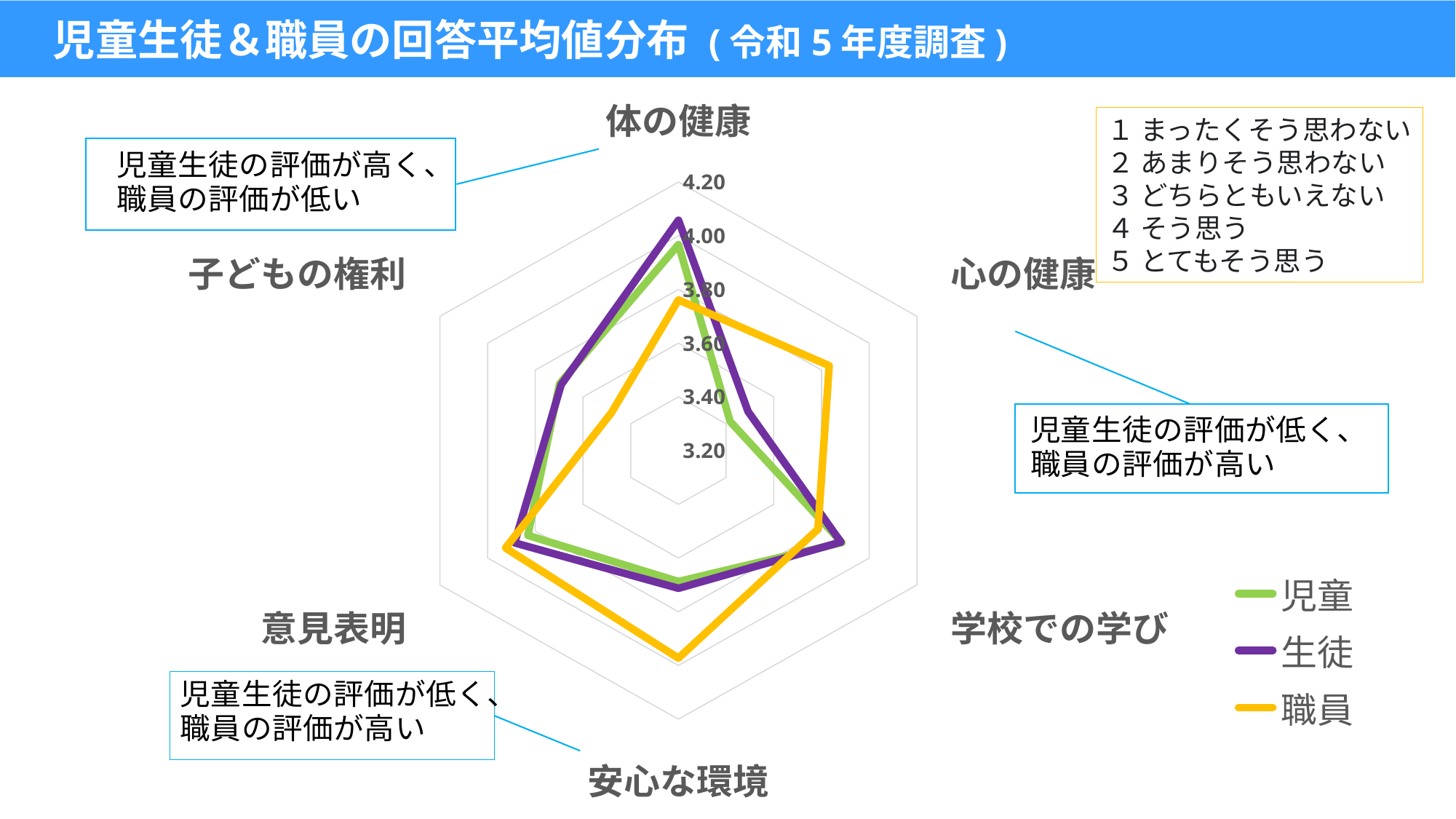
What is the title of the slide? 児童生徒＆職員の回答平均値分布（令和5年度調査） Is the value for 職員 on 子どもの権利 greater or less than 3.60? less Is the value for 生徒 on 体の健康 greater or less than 4.00? greater How many series does the legend list? 3 On 子どもの権利, which series has the larger value, 生徒 or 職員? 生徒 How many categories (axes) does the radar chart have? 6 Is the value for 児童 on 心の健康 greater or less than 3.60? less What kind of chart is shown on the slide? Radar chart On 心の健康, which series has the larger value, 職員 or 児童? 職員 Which colour represents the 職員 series in the legend? Yellow On 安心な環境, which series has the larger value, 職員 or 児童? 職員